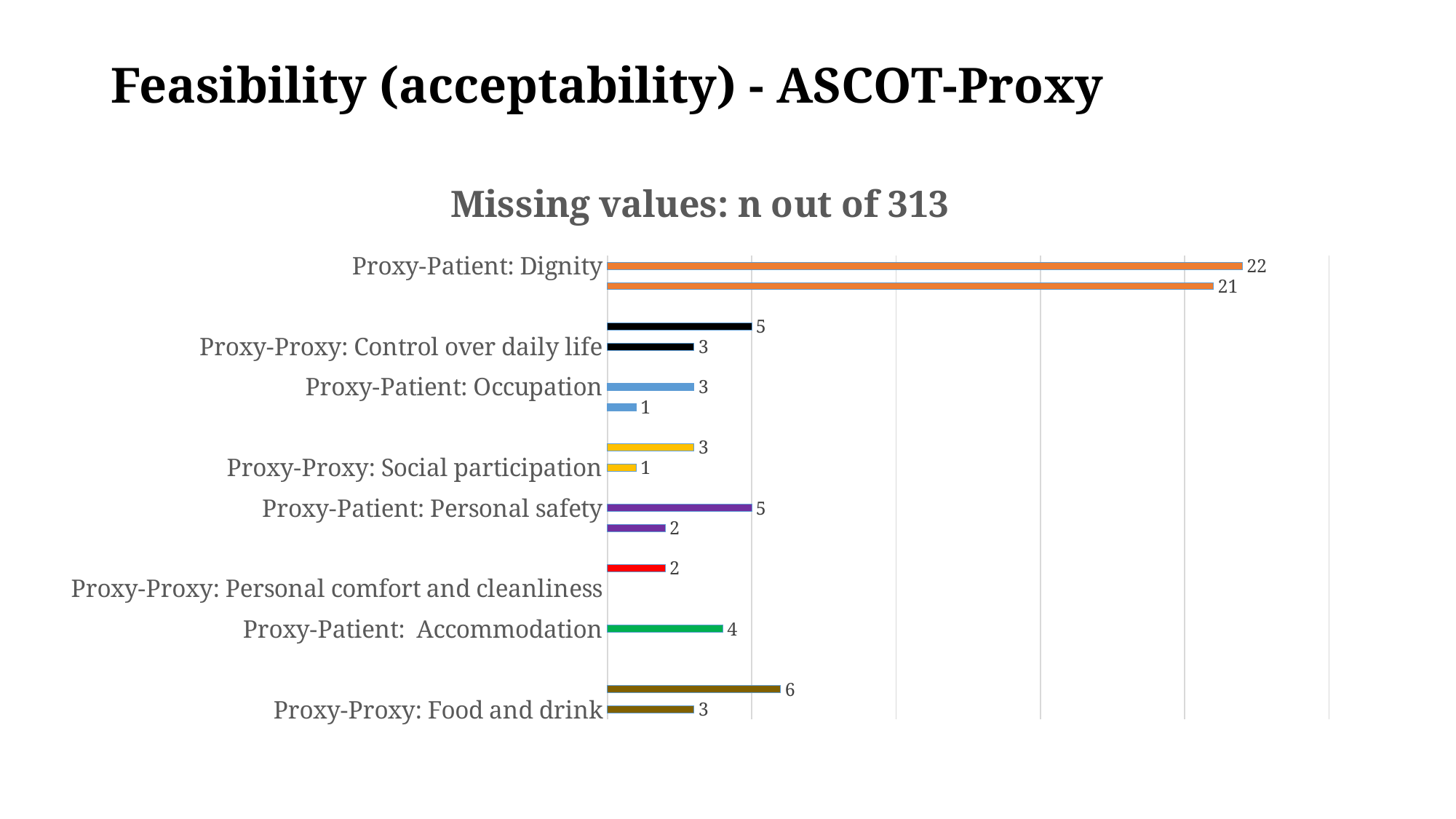
Which category has the highest missing value in the chart? Proxy-Patient: Dignity What is the value of the bar for Proxy-Patient: Accommodation? 4 How many category labels are listed on the vertical axis of the chart? 8 What is the largest value shown for Proxy-Patient: Dignity? 22 What is the value of the longer bar for Proxy-Patient: Personal safety? 5 What kind of chart is shown on the slide? bar chart What is the title of the chart? Missing values: n out of 313